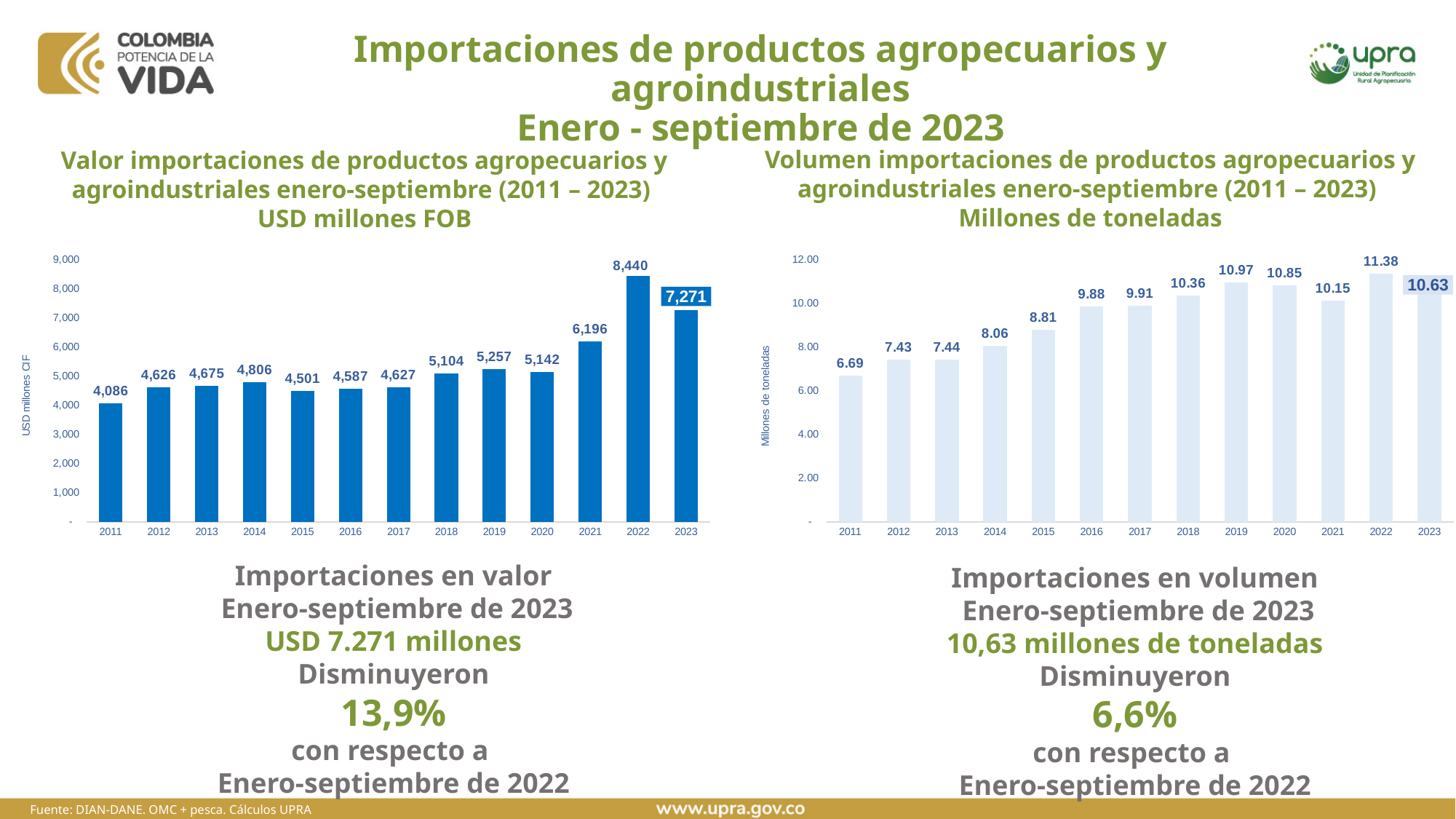
In the right chart (Volumen importaciones), which year has the lowest value? 2011 In the left chart (Valor importaciones), what is the value for 2023? 7,271 What type of chart is the right chart (Volumen importaciones)? Bar chart In the left chart (Valor importaciones), which year has the highest value? 2022 In the left chart (Valor importaciones), which year has the lowest value? 2011 In the right chart (Volumen importaciones), what is the value for 2019? 10.97 In the right chart (Volumen importaciones), which year has the highest value? 2022 In the left chart (Valor importaciones), what is the difference between the values for 2022 and 2023? 1,169 In the right chart (Volumen importaciones), which is larger, the value for 2020 or the value for 2021? 2020 In the left chart (Valor importaciones), how many years are plotted? 13 In the left chart (Valor importaciones), what is the y-axis label? USD millones CIF In the right chart (Volumen importaciones), what is the difference between the values for 2022 and 2023? 0.75